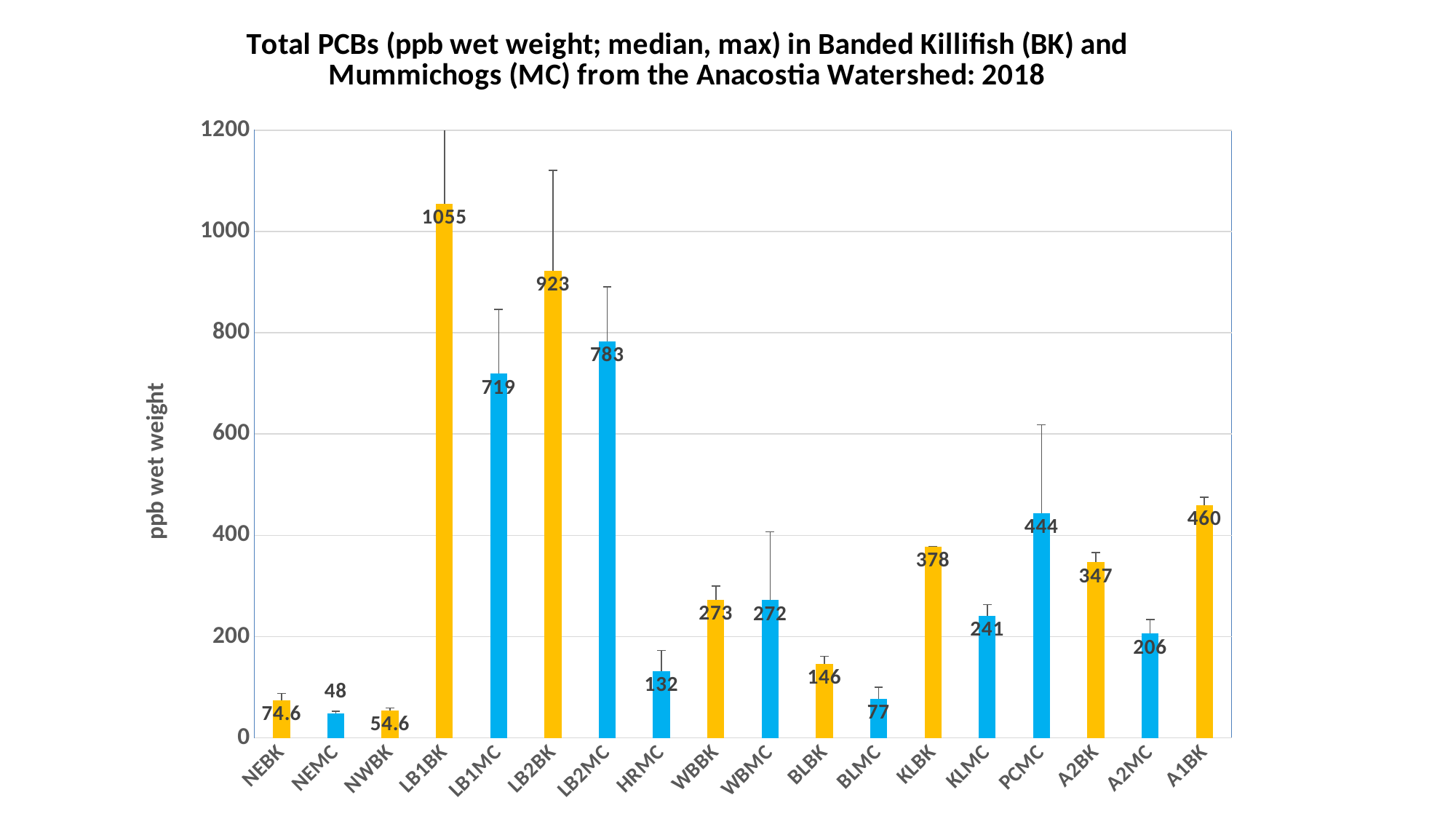
Which category has the highest value? LB1BK What is the value for NEBK? 74.6 What is the difference between the values for LB2BK and LB2MC? 140 Is the value for HRMC greater or less than 200? less What is the value for LB1MC? 719 How many categories are shown on the x axis? 18 What kind of chart is shown on the slide? bar chart What colour are the bars for the MC (Mummichog) categories? blue What is the label of the y axis? ppb wet weight Which category has the lowest value? NEMC Which is larger, the value for A1BK or the value for PCMC? A1BK What is the value for PCMC? 444